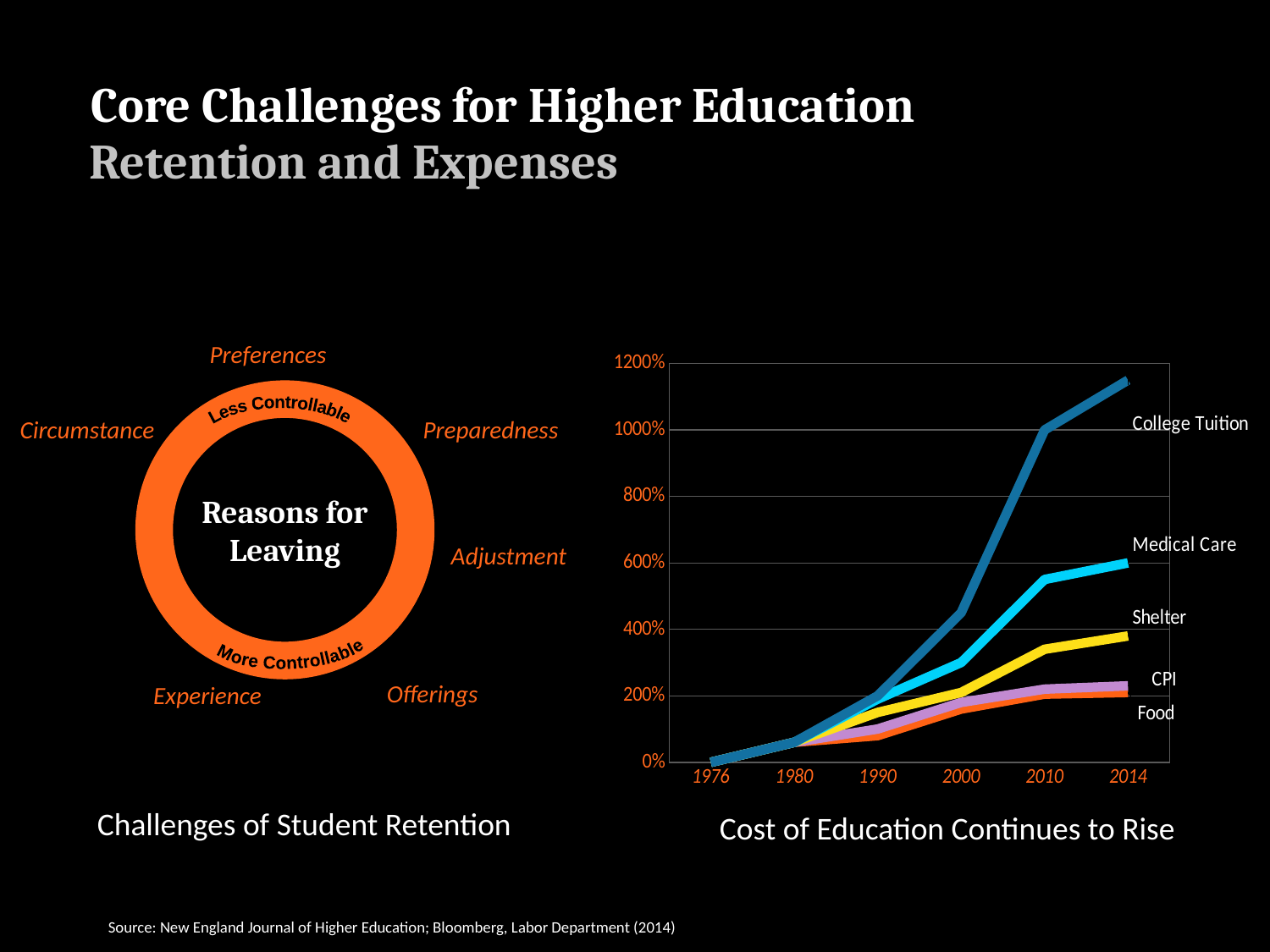
How many years are marked on the x axis of the 'Cost of Education Continues to Rise' chart? 6 What is the highest tick value shown on the y axis of the 'Cost of Education Continues to Rise' chart? 1200% In the 'Cost of Education Continues to Rise' chart, is the value for College Tuition in 2014 greater or less than 1000%? greater In the 'Cost of Education Continues to Rise' chart, is the value for Medical Care in 2010 greater or less than 400%? greater In the 'Cost of Education Continues to Rise' chart, which series has the lowest value in 2014? Food In the 'Cost of Education Continues to Rise' chart, is the value for College Tuition in 2000 greater or less than 600%? less What kind of chart is 'Cost of Education Continues to Rise'? line chart In the 'Cost of Education Continues to Rise' chart, does the College Tuition line rise or fall from 1976 to 2014? rise In the 'Cost of Education Continues to Rise' chart, which is larger in 2014: Medical Care or Shelter? Medical Care In the 'Cost of Education Continues to Rise' chart, which series has the highest value in 2014? College Tuition How many series are plotted in the 'Cost of Education Continues to Rise' chart? 5